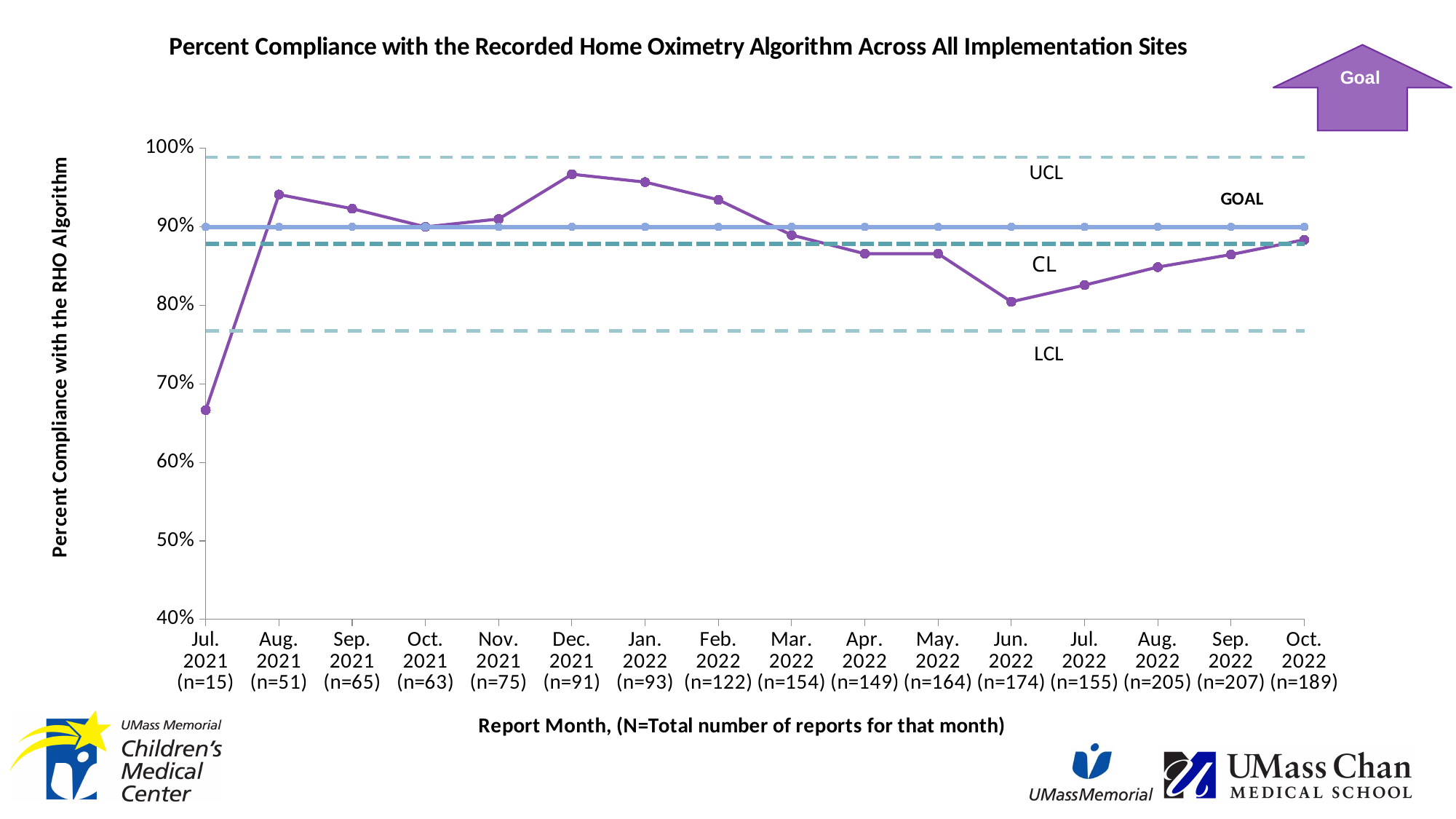
How many report months are plotted along the x axis? 16 Is the percent compliance for Apr. 2022 greater or less than 90%? less Is the percent compliance for Jul. 2022 greater or less than 80%? greater Which report month has the highest percent compliance? Dec. 2021 Do the percent compliance values rise or fall from Dec. 2021 to Jun. 2022? fall Which is larger, the percent compliance for Dec. 2021 or for Jun. 2022? Dec. 2021 What is the title of the chart? Percent Compliance with the Recorded Home Oximetry Algorithm Across All Implementation Sites What kind of chart is shown on the slide? line chart Is the percent compliance for Dec. 2021 greater or less than 90%? greater Which report month has the lowest percent compliance? Jul. 2021 At what percent compliance is the GOAL line drawn? 90%